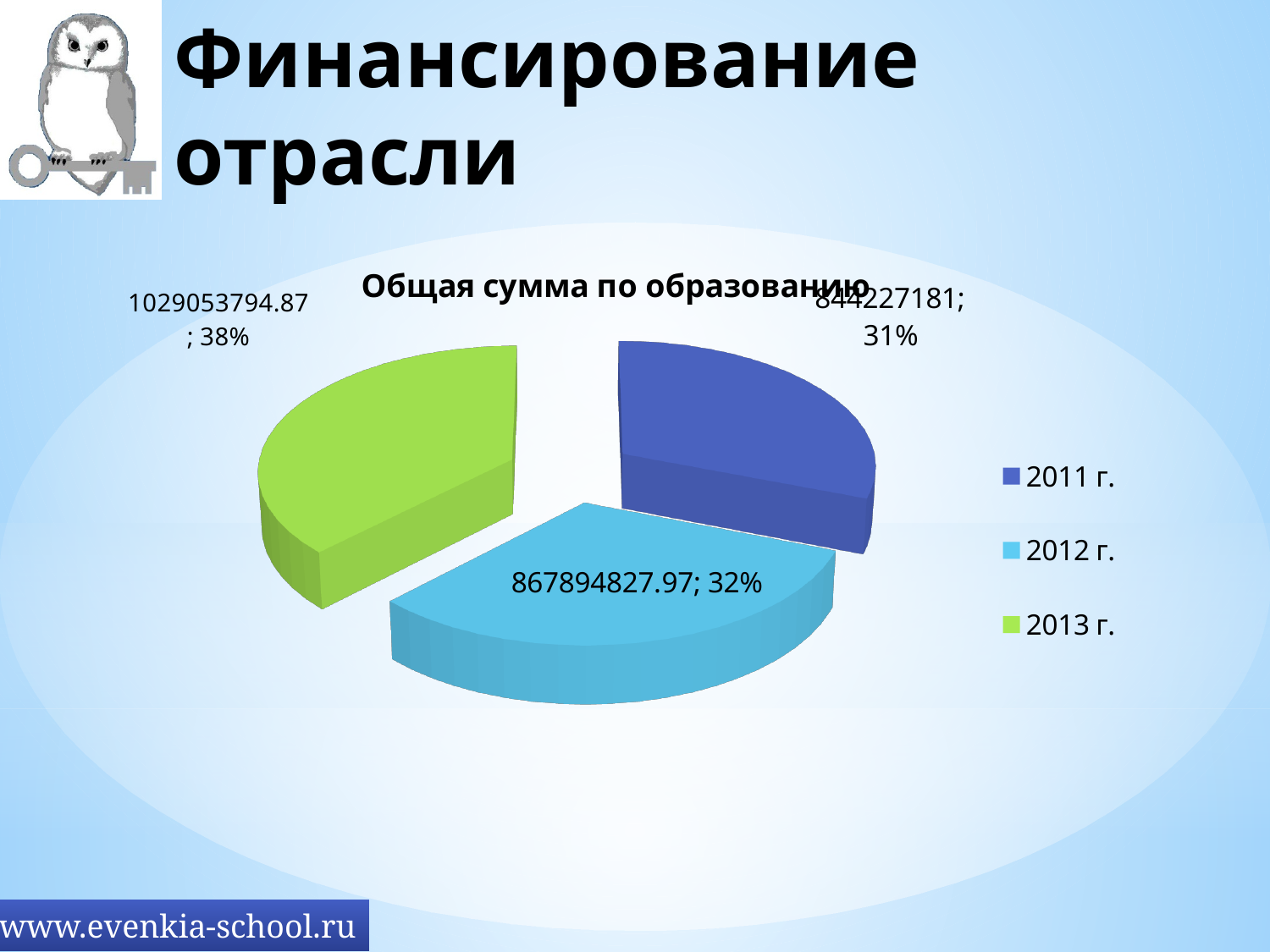
What kind of chart is shown on the slide? pie chart What share of the pie does 2013 г. represent? 38% What share of the pie does 2011 г. represent? 31% What is the value for 2012 г.? 867894827.97 Which year has the smallest slice? 2011 г. What is the value for 2011 г.? 844227181 Which year has the largest slice? 2013 г. What is the title of the chart? Общая сумма по образованию What is the difference between the values for 2013 г. and 2012 г.? 161158966.90 How many series does the legend list? 3 Which colour represents 2012 г. in the legend? light blue What is the value for 2013 г.? 1029053794.87